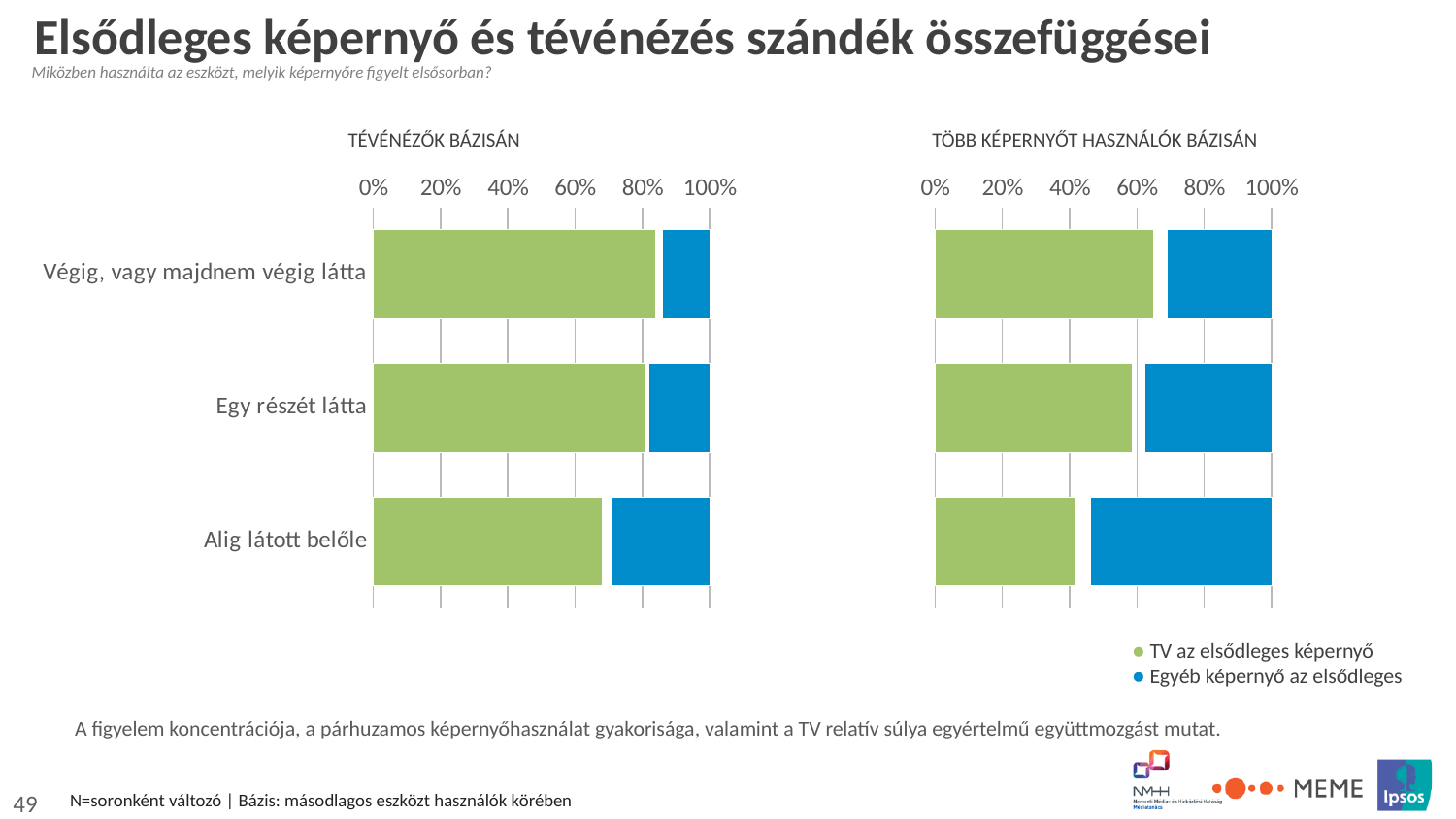
In the 'TÉVÉNÉZŐK BÁZISÁN' chart, is the value of 'TV az elsődleges képernyő' for 'Alig látott belőle' greater or less than 80%? less How many series does the legend list for the charts? 2 What kind of chart is used on the slide for the 'TÉVÉNÉZŐK BÁZISÁN' chart? Bar chart Which colour represents 'Egyéb képernyő az elsődleges' in the charts? Blue In the 'TÖBB KÉPERNYŐT HASZNÁLÓK BÁZISÁN' chart, is the value of 'TV az elsődleges képernyő' for 'Alig látott belőle' greater or less than 60%? less In the 'TÖBB KÉPERNYŐT HASZNÁLÓK BÁZISÁN' chart, which category has the highest value for 'TV az elsődleges képernyő'? Végig, vagy majdnem végig látta For 'Alig látott belőle', is the 'TV az elsődleges képernyő' share larger in the 'TÉVÉNÉZŐK BÁZISÁN' chart or in the 'TÖBB KÉPERNYŐT HASZNÁLÓK BÁZISÁN' chart? TÉVÉNÉZŐK BÁZISÁN In the 'TÖBB KÉPERNYŐT HASZNÁLÓK BÁZISÁN' chart, does the share of 'TV az elsődleges képernyő' rise or fall going from 'Végig, vagy majdnem végig látta' down to 'Alig látott belőle'? fall In the 'TÉVÉNÉZŐK BÁZISÁN' chart, which category has the lowest value for 'TV az elsődleges képernyő'? Alig látott belőle In the 'TÉVÉNÉZŐK BÁZISÁN' chart, is the value of 'TV az elsődleges képernyő' for 'Végig, vagy majdnem végig látta' greater or less than 80%? greater How many categories are shown in the 'TÉVÉNÉZŐK BÁZISÁN' chart? 3